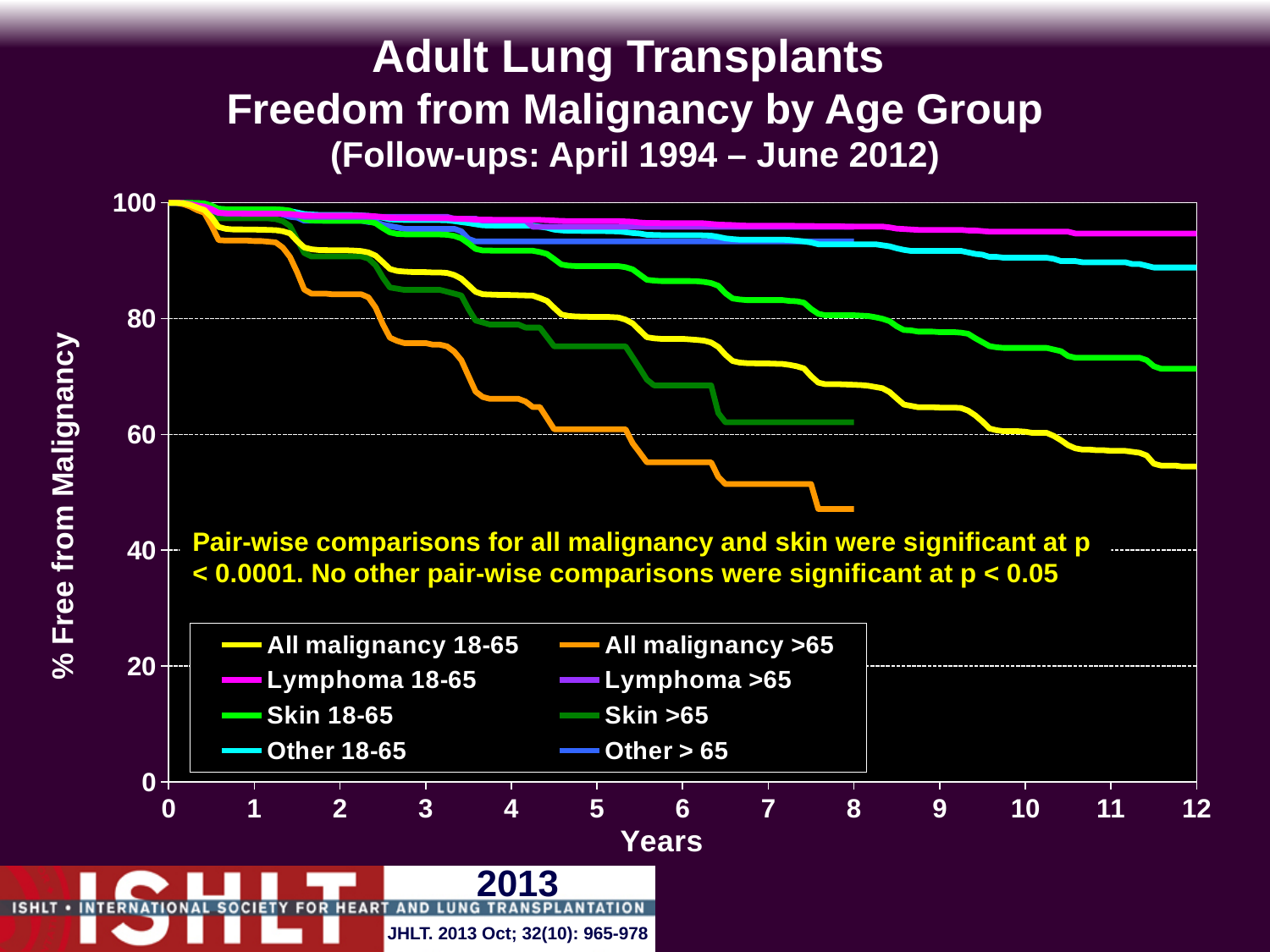
What kind of chart is shown on the slide? Line chart How many series does the legend list? 8 Is the value for Skin 18-65 at 12 years greater or less than 80? less Do the curves rise or fall as years increase? Fall Is the value for Lymphoma 18-65 at 12 years greater or less than 80? greater Is the value for All malignancy 18-65 at 12 years greater or less than 60? less What is the label of the y axis? % Free from Malignancy What is the title of the chart? Adult Lung Transplants Freedom from Malignancy by Age Group (Follow-ups: April 1994 – June 2012) Which series has the highest value at 12 years? Lymphoma 18-65 At 8 years, which is larger: All malignancy 18-65 or All malignancy >65? All malignancy 18-65 Which series has the lowest value at 8 years? All malignancy >65